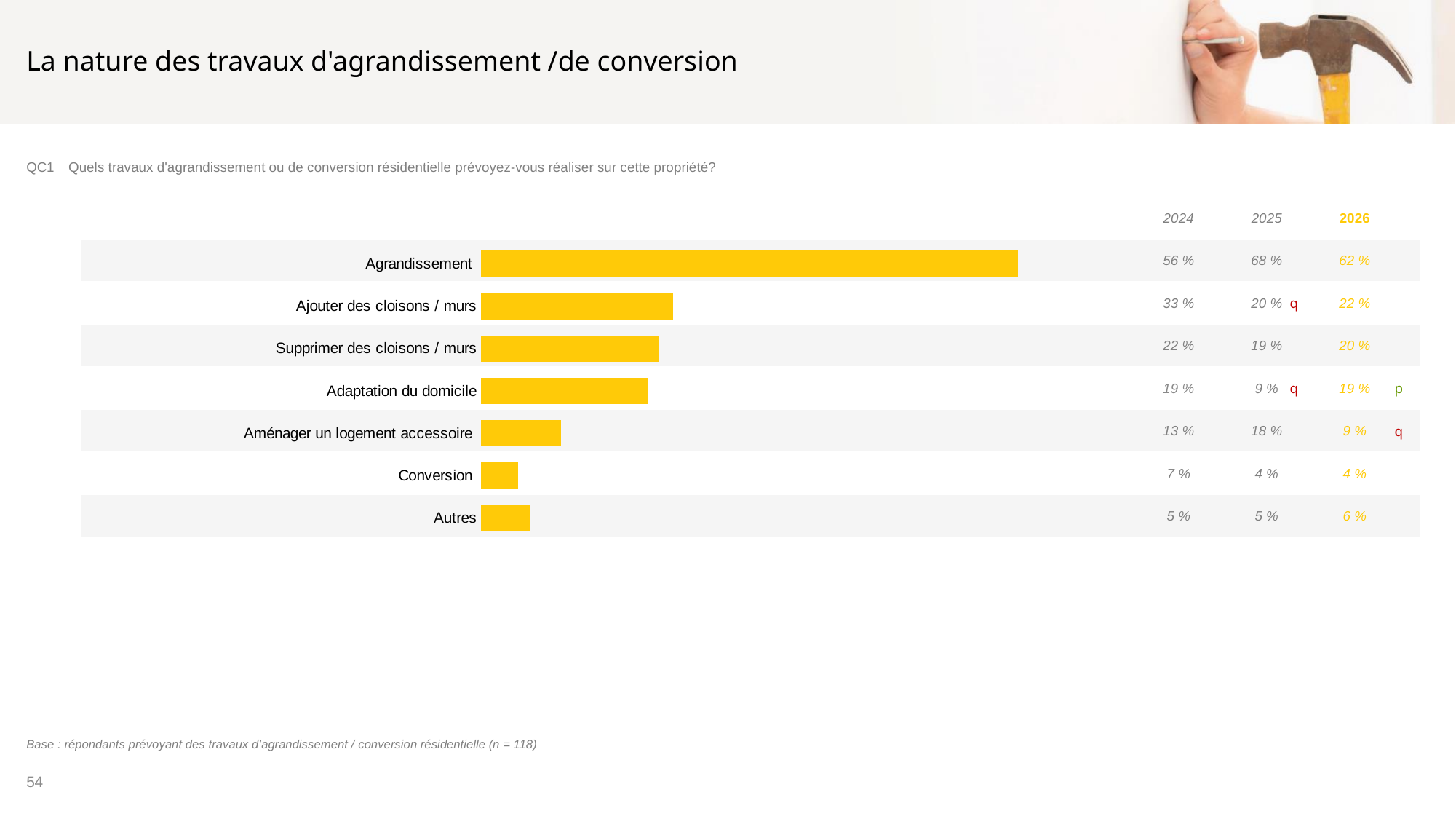
What is the 2024 value for Aménager un logement accessoire? 13 % How many years are listed in the table columns? 3 What is the difference between the 2024 and 2025 values for Agrandissement? 12 % How many categories are shown in the chart? 7 What is the base size (n) stated at the bottom of the slide? 118 Which category has the highest 2026 value? Agrandissement What is the difference between the 2025 and 2026 values for Adaptation du domicile? 10 % Which category has the lowest 2026 value? Conversion What kind of chart is shown on the slide? Bar chart Which is larger for 2026: Ajouter des cloisons / murs or Supprimer des cloisons / murs? Ajouter des cloisons / murs What is the 2026 value for Agrandissement? 62 % What is the 2025 value for Ajouter des cloisons / murs? 20 %